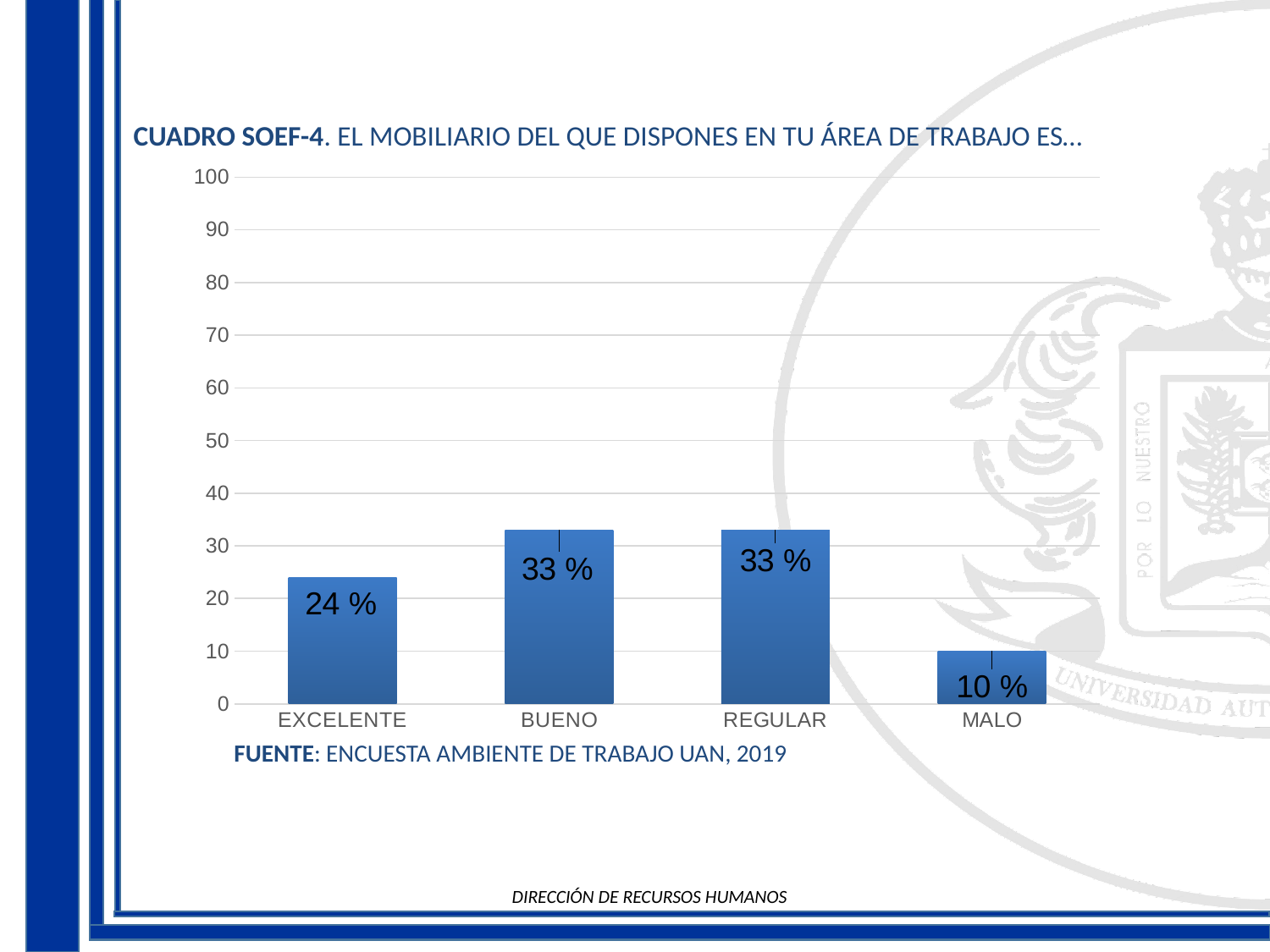
Which is larger, the value for EXCELENTE or the value for MALO? EXCELENTE What is the value for BUENO? 33 % How many categories are shown on the x axis? 4 What is the value for EXCELENTE? 24 % What is the difference between the values for REGULAR and EXCELENTE? 9 % Which category has the lowest value? MALO What is the difference between the values for BUENO and MALO? 23 % What is the value for MALO? 10 % What is the highest value shown on the y axis? 100 What is the source cited below the chart? ENCUESTA AMBIENTE DE TRABAJO UAN, 2019 What kind of chart is shown on the slide? bar chart Is the value for EXCELENTE greater or less than 30? less